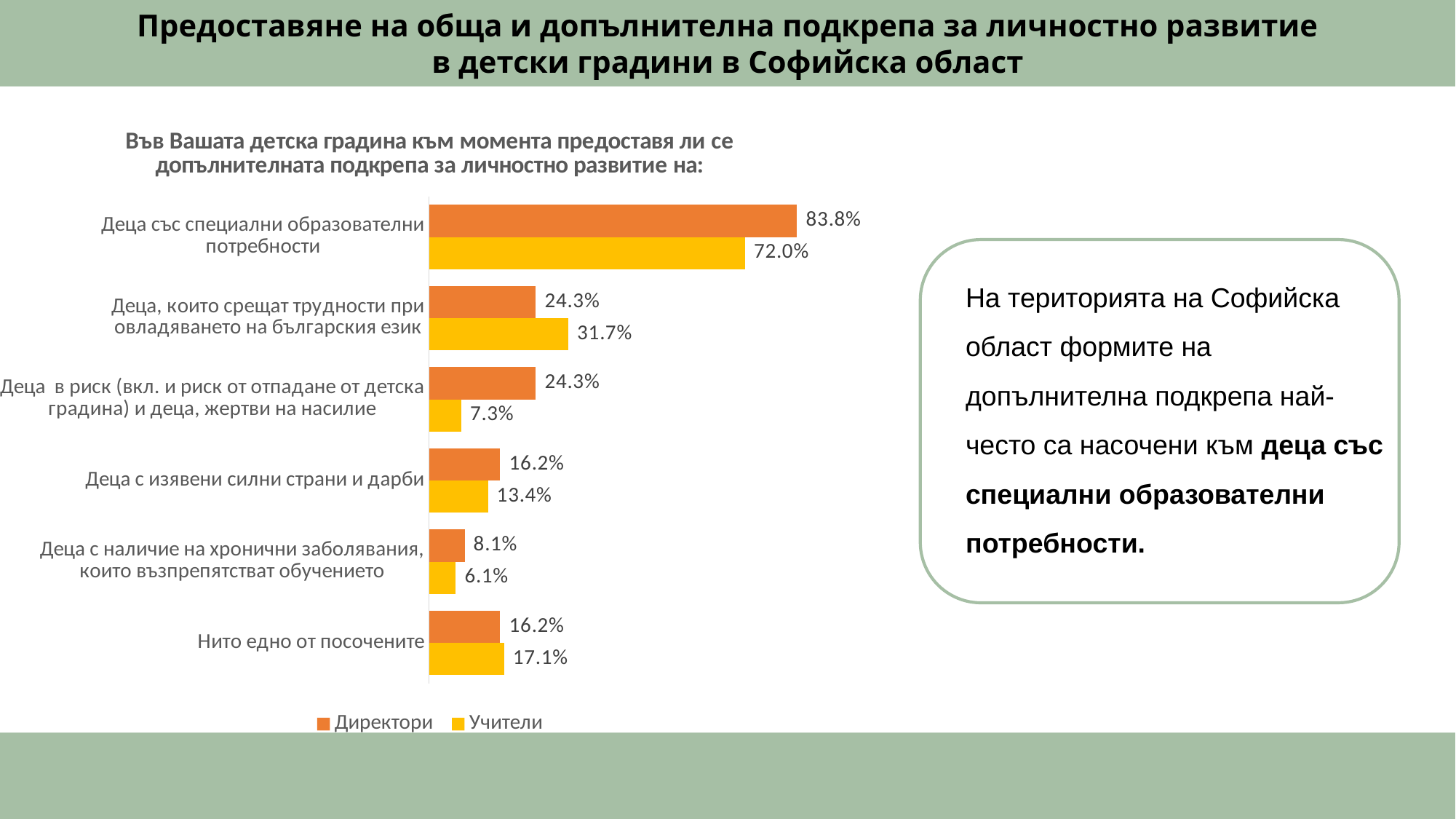
What is the difference between the Директори and Учители values for 'Деца със специални образователни потребности'? 11.8% Which category has the highest value for Директори? Деца със специални образователни потребности What value is shown for Учители for 'Деца със специални образователни потребности'? 72.0% How many series does the legend list? 2 For 'Деца, които срещат трудности при овладяването на българския език', which series has the larger value, Директори or Учители? Учители What value is shown for Учители for 'Деца, които срещат трудности при овладяването на българския език'? 31.7% What value is shown for Директори for 'Деца с наличие на хронични заболявания, които възпрепятстват обучението'? 8.1% What value is shown for Учители for 'Деца в риск (вкл. и риск от отпадане от детска градина) и деца, жертви на насилие'? 7.3% Which category has the lowest value for Учители? Деца с наличие на хронични заболявания, които възпрепятстват обучението What value is shown for Директори for 'Деца със специални образователни потребности'? 83.8% How many categories are shown in the chart? 6 What kind of chart is shown on the slide? Bar chart